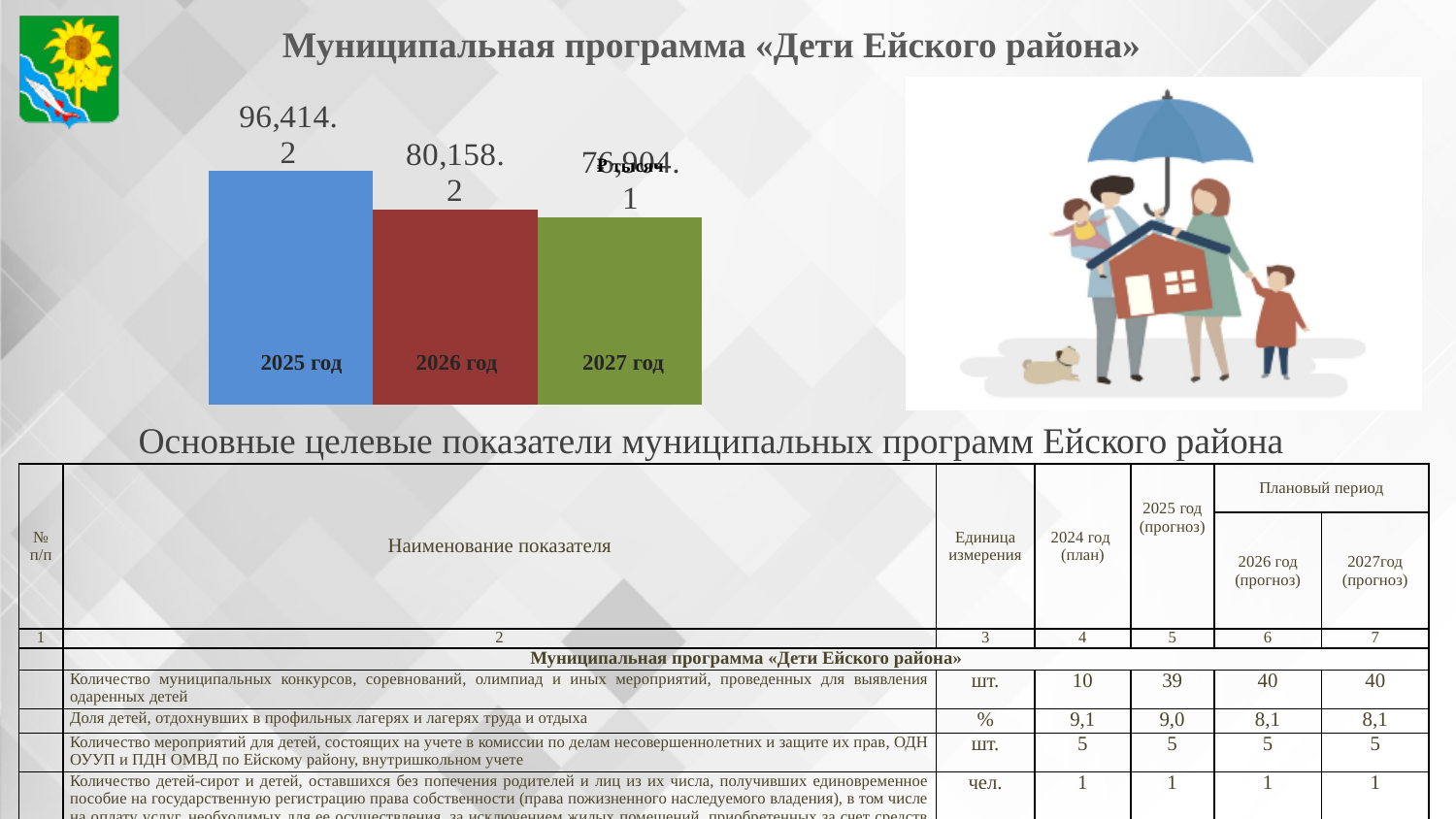
What is the value shown for 2026 год in the bar chart? 80,158.2 What is the difference between the values for 2025 год and 2026 год? 16,256.0 What colour is the bar for 2027 год? Green How many bars (years) are shown in the chart? 3 Which year has the lowest bar in the chart? 2027 год What colour is the bar for 2025 год? Blue What type of chart is shown on the slide? Bar chart Do the values rise or fall from 2025 год to 2027 год? Fall Which year has the highest bar in the chart? 2025 год What is the value shown for 2025 год in the bar chart? 96,414.2 Which is larger, the value for 2025 год or the value for 2026 год? 2025 год